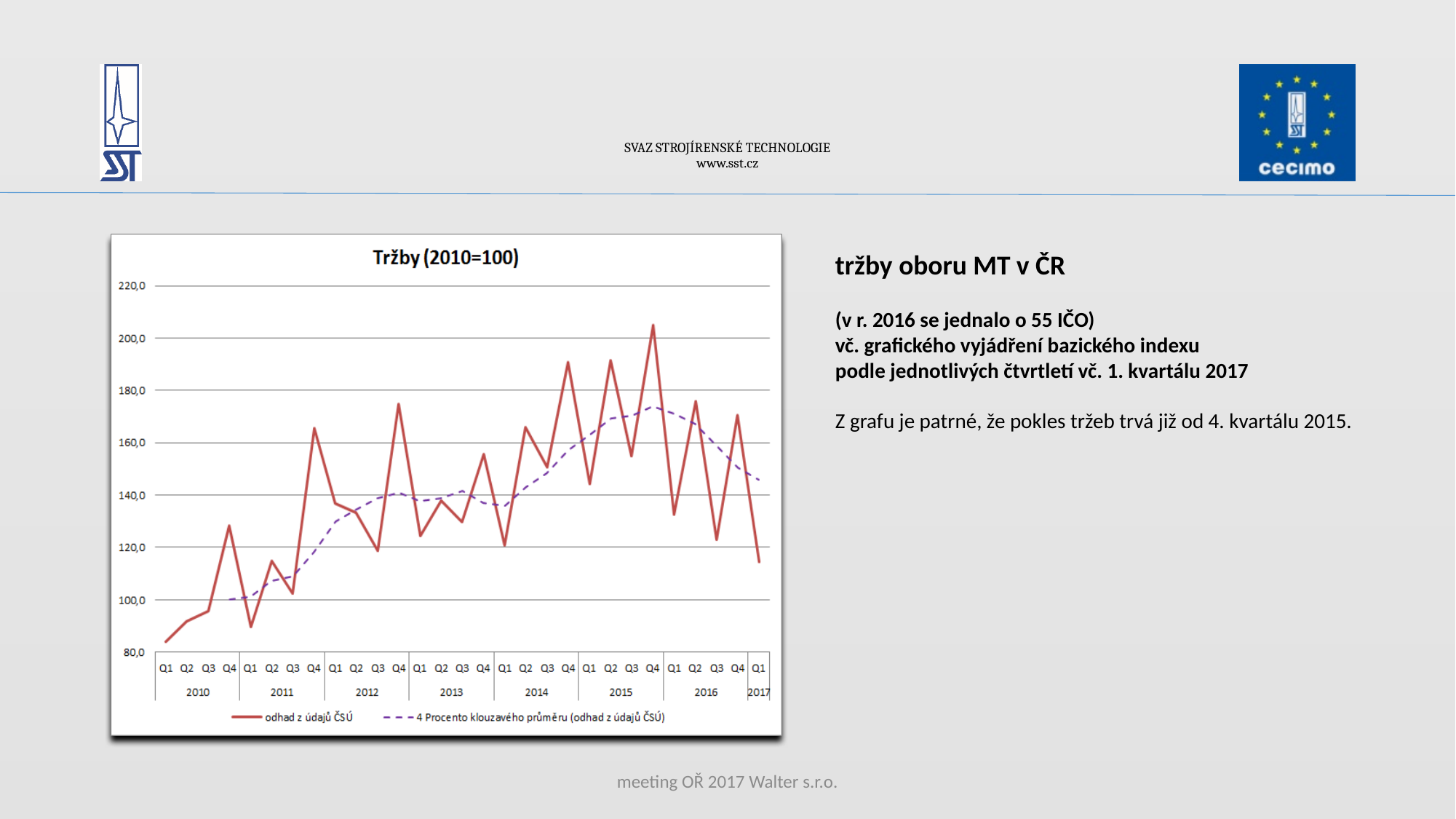
Which is larger for 'odhad z údajů ČSÚ': the value for Q4 2015 or the value for Q4 2016? Q4 2015 Is the value of 'odhad z údajů ČSÚ' for Q1 2017 greater or less than 120,0? less Is the value of 'odhad z údajů ČSÚ' for Q4 2015 greater or less than 200,0? greater What is the title of the chart? Tržby (2010=100) Is the value of 'odhad z údajů ČSÚ' for Q4 2011 greater or less than 160,0? greater In which quarter does the solid line 'odhad z údajů ČSÚ' reach its highest value? Q4 2015 Does the solid line 'odhad z údajů ČSÚ' generally rise or fall from Q4 2015 to Q1 2017? fall In which quarter does the solid line 'odhad z údajů ČSÚ' have its lowest value? Q1 2010 What kind of chart is shown on the slide? line chart How many quarterly points are plotted along the x axis of the chart? 29 How many series does the chart legend list? 2